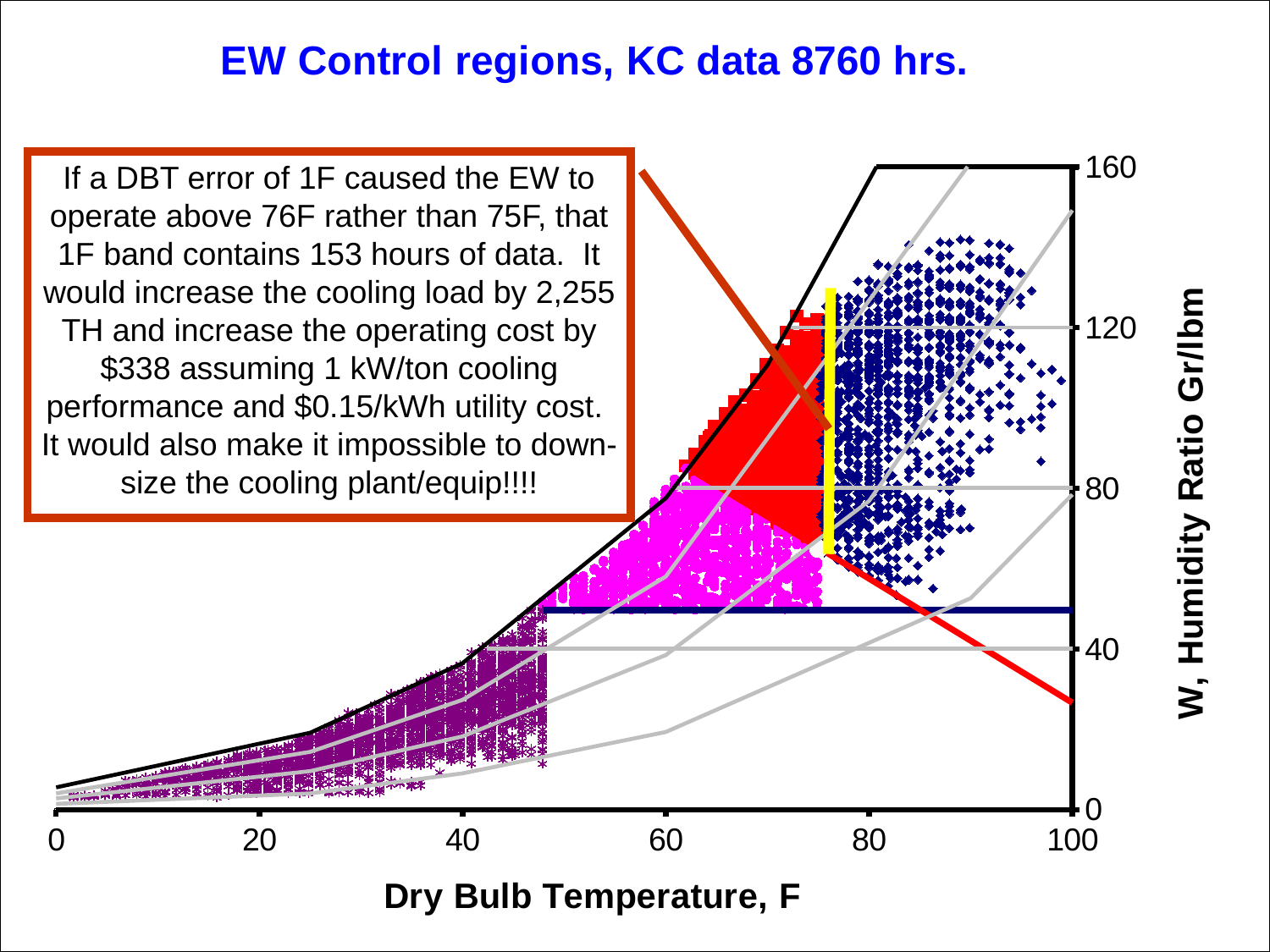
What is the label of the horizontal axis of the chart? Dry Bulb Temperature, F Is the Dry Bulb Temperature at which the yellow vertical line is drawn greater or less than 60? greater What is the title of the chart? EW Control regions, KC data 8760 hrs. Does the upper black boundary line of the chart rise or fall as Dry Bulb Temperature increases from 0 to 80? rise Is the humidity ratio of the dark blue horizontal line greater or less than 40? greater Which coloured data region lies at the highest Dry Bulb Temperatures: the purple region or the blue region? blue How many differently coloured data regions (purple, magenta, red, blue) are plotted on the chart? 4 Is the humidity ratio where the red sloping line reaches 100 F greater or less than 40? less What kind of chart is shown on the slide? Scatter chart What is the highest value shown on the vertical axis (W, Humidity Ratio Gr/lbm)? 160 What is the highest value shown on the Dry Bulb Temperature axis? 100